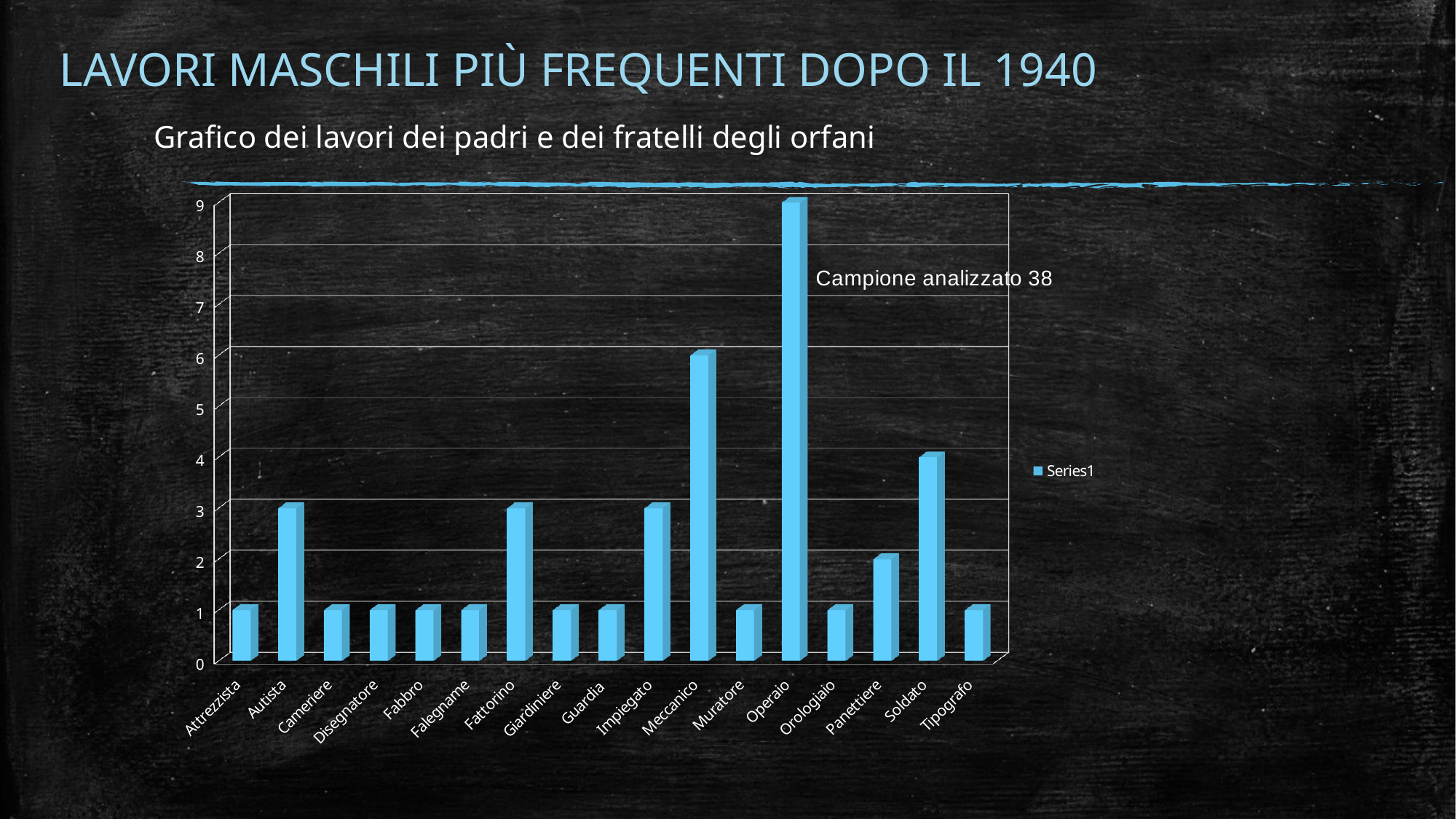
What is the value for Meccanico? 6 What kind of chart is shown on the slide? bar chart Which category has the highest value? Operaio What is the name of the series shown in the legend? Series1 How many series does the legend list? 1 What is the difference between the values for Operaio and Meccanico? 3 What is the value for Panettiere? 2 Is the value for Autista greater or less than 2? greater What is the value for Soldato? 4 What is the value for Operaio? 9 How many categories are shown on the x axis? 17 Which is larger, the value for Meccanico or the value for Soldato? Meccanico